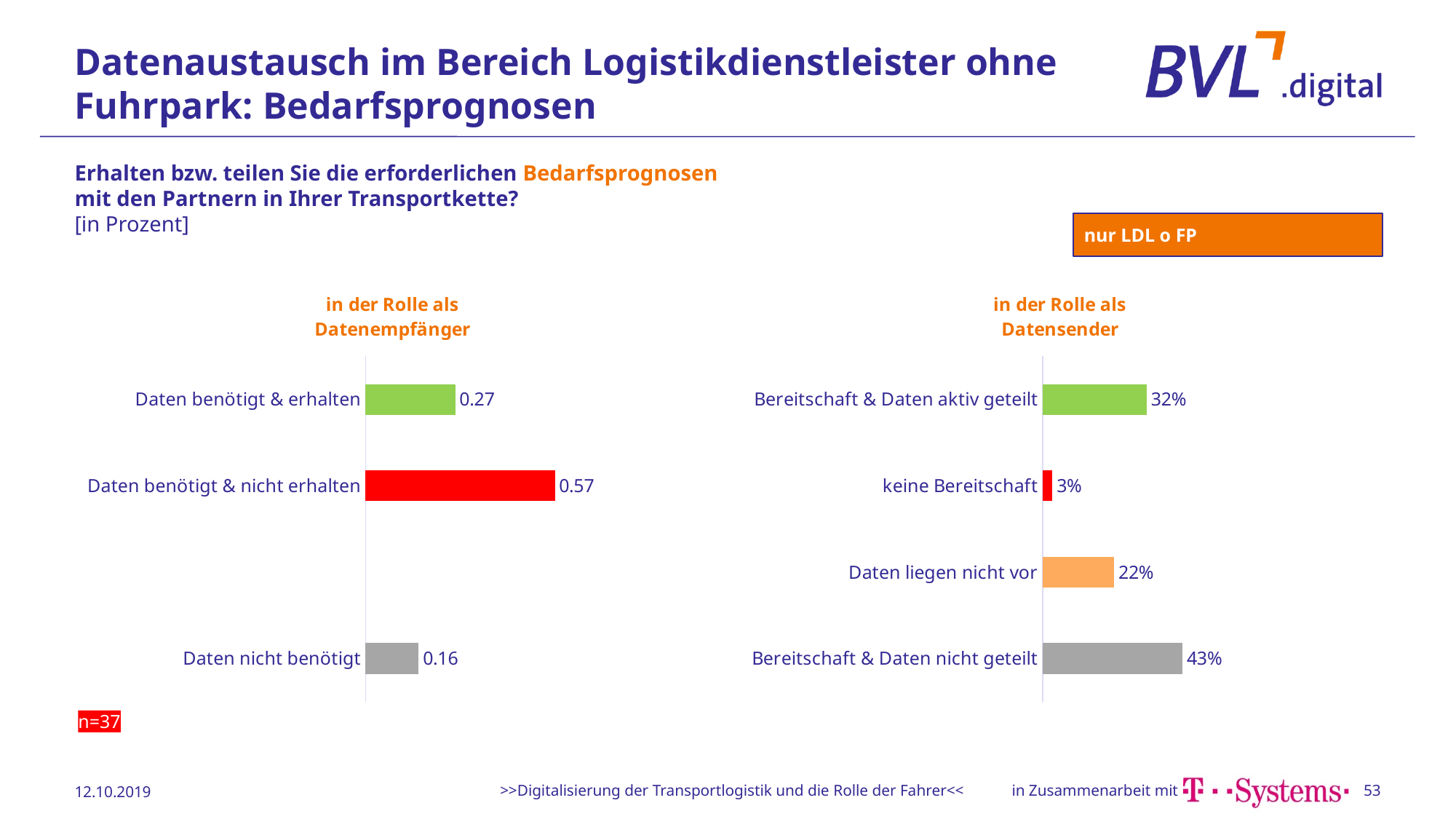
In the 'in der Rolle als Datensender' chart, what is the value for 'Bereitschaft & Daten aktiv geteilt'? 32% How many categories are shown in the 'in der Rolle als Datensender' chart? 4 In the 'in der Rolle als Datensender' chart, which category has the lowest value? keine Bereitschaft In the 'in der Rolle als Datenempfänger' chart, what is the difference between 'Daten benötigt & nicht erhalten' and 'Daten benötigt & erhalten'? 0.30 In the 'in der Rolle als Datenempfänger' chart, what is the value for 'Daten benötigt & nicht erhalten'? 0.57 In the 'in der Rolle als Datensender' chart, which category has the highest value? Bereitschaft & Daten nicht geteilt In the 'in der Rolle als Datensender' chart, what is the difference between 'Bereitschaft & Daten nicht geteilt' and 'Bereitschaft & Daten aktiv geteilt'? 11% In the 'in der Rolle als Datenempfänger' chart, what is the value for 'Daten nicht benötigt'? 0.16 In the 'in der Rolle als Datensender' chart, what is the value for 'Daten liegen nicht vor'? 22% What type of chart is the 'in der Rolle als Datensender' chart? Bar chart In the 'in der Rolle als Datenempfänger' chart, which category has the highest value? Daten benötigt & nicht erhalten How many categories are shown in the 'in der Rolle als Datenempfänger' chart? 3